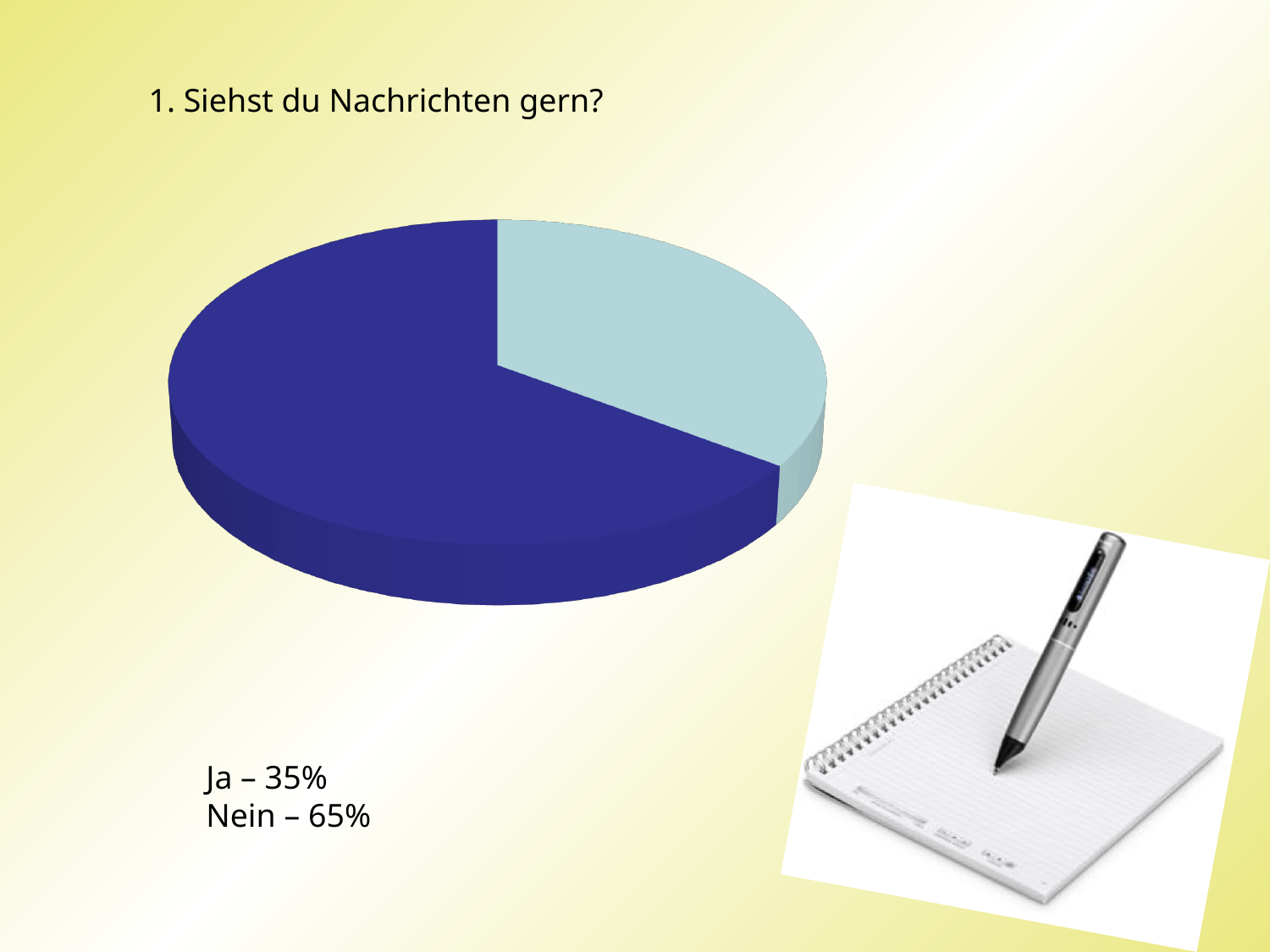
What percentage of respondents answered "Nein"? 65% What question is the pie chart about, as written at the top of the slide? 1. Siehst du Nachrichten gern? By how many percentage points does "Nein" exceed "Ja"? 30% Which is larger, the share for "Ja" or the share for "Nein"? Nein Which answer has the larger share of the pie? Nein How many slices does the pie chart have? 2 Which answer has the smaller share of the pie? Ja What share of the pie does "Ja" represent? 35% What colour is the larger slice of the pie chart? dark blue Does "Nein" account for more or less than half of the pie? more What kind of chart is shown on the slide? pie chart What percentage of respondents answered "Ja"? 35%